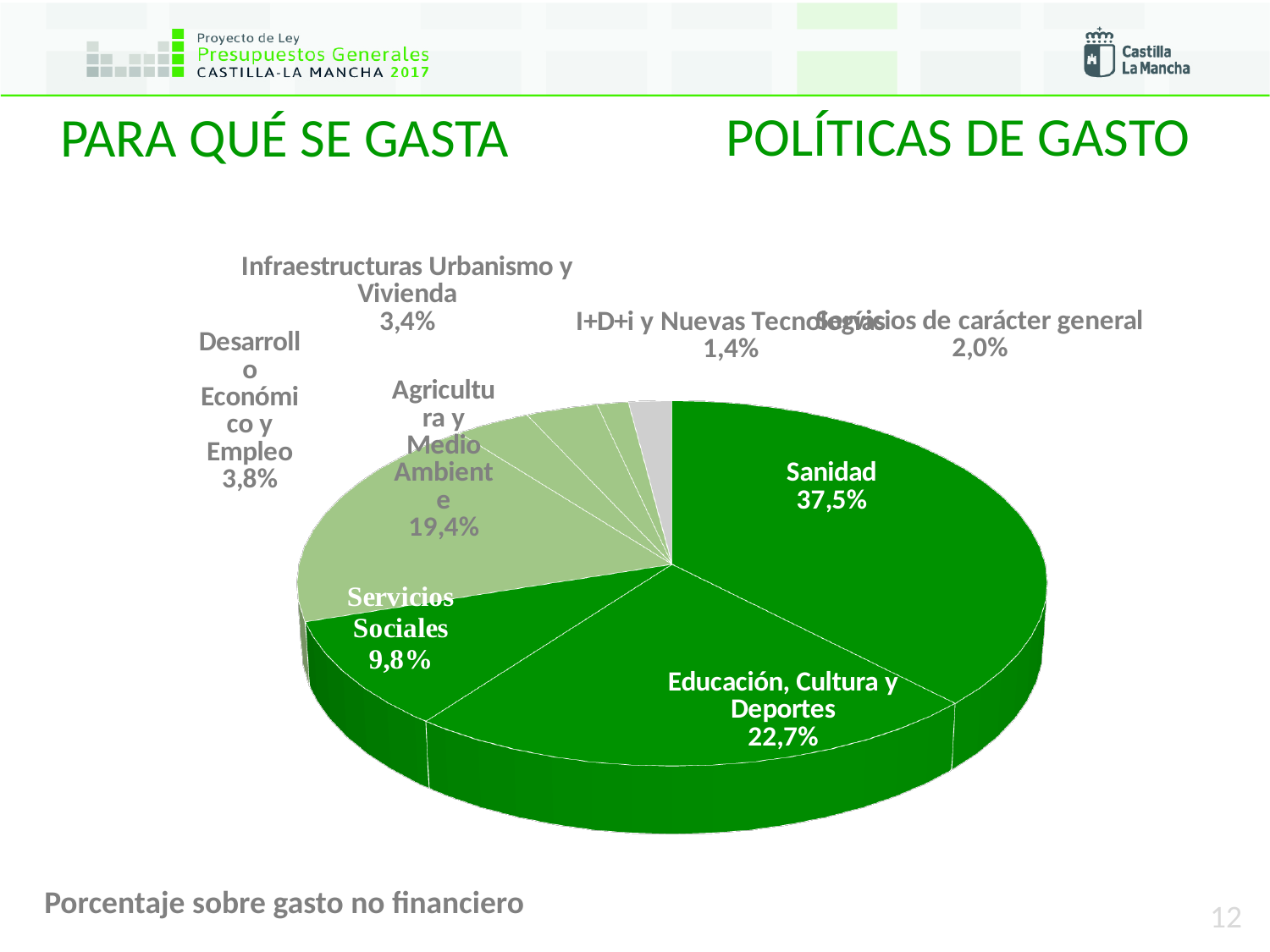
What is the value for Servicios de carácter general? 2,0% What percentage is shown for Servicios Sociales? 9,8% What type of chart is shown on the slide? Pie chart Which is larger, Desarrollo Económico y Empleo or Infraestructuras Urbanismo y Vivienda? Desarrollo Económico y Empleo What percentage is shown for Educación, Cultura y Deportes? 22,7% How many categories are shown in the pie chart? 8 What is the value for Agricultura y Medio Ambiente? 19,4% What is the difference in percentage points between Sanidad and Educación, Cultura y Deportes? 14,8 Which category has the largest share of the pie? Sanidad What does the note at the bottom of the slide say the percentages are based on? Porcentaje sobre gasto no financiero Which category has the smallest share of the pie? I+D+i y Nuevas Tecnologías What percentage does the Sanidad slice represent? 37,5%